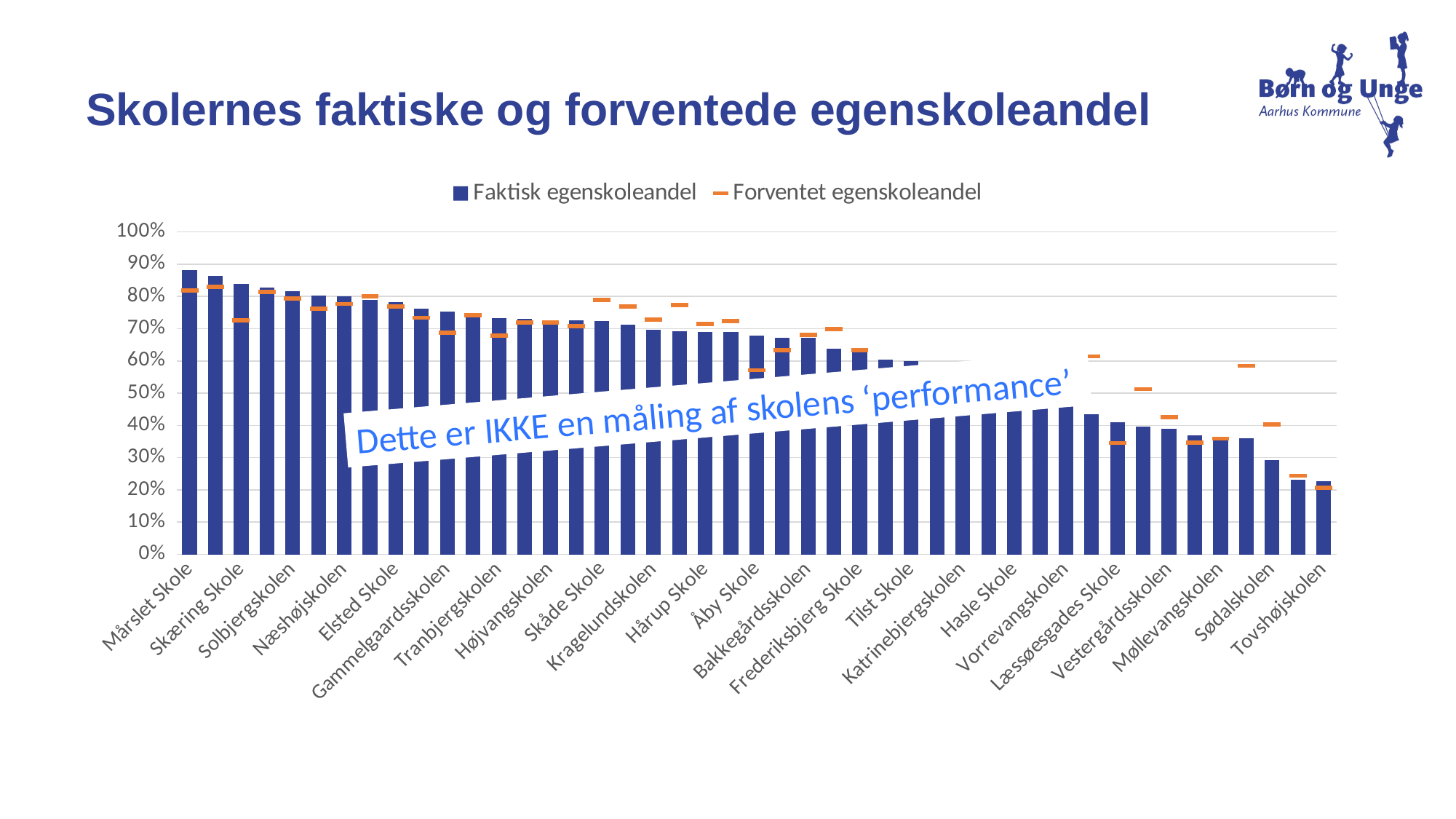
Is the Faktisk egenskoleandel for Tovshøjskolen greater or less than 30%? less Which school has the lowest Faktisk egenskoleandel? Tovshøjskolen How many series does the legend list? 2 Is the Forventet egenskoleandel for Tovshøjskolen greater or less than 30%? less Do the Faktisk egenskoleandel bars rise or fall from left to right along the x axis? Fall Is the Faktisk egenskoleandel for Skæring Skole greater or less than 70%? greater What is the title of the chart? Skolernes faktiske og forventede egenskoleandel What kind of chart is shown on the slide? Bar chart Which has the larger Faktisk egenskoleandel, Mårslet Skole or Tovshøjskolen? Mårslet Skole What colour are the Forventet egenskoleandel markers? Orange Which school has the highest Faktisk egenskoleandel? Mårslet Skole